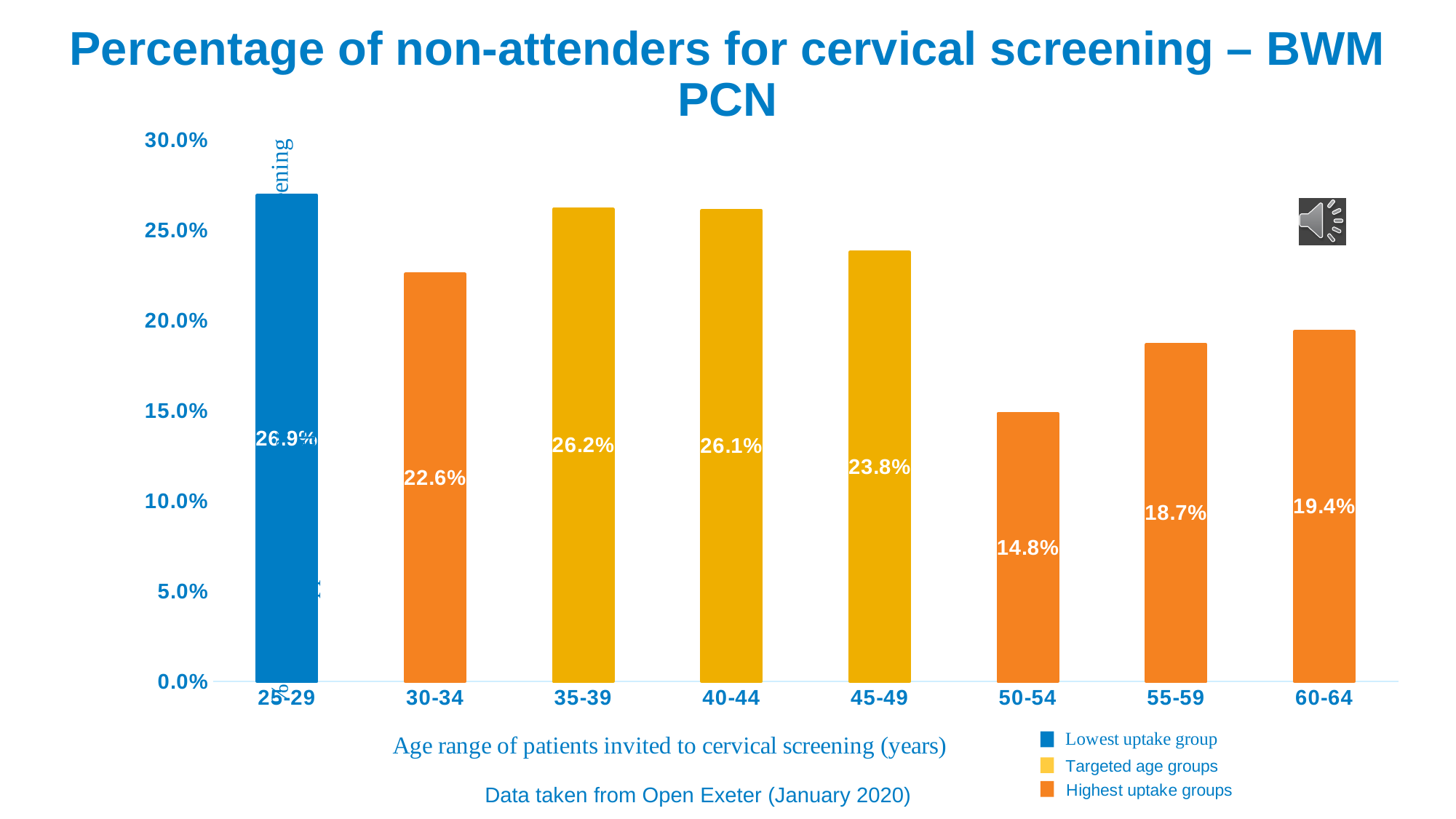
What is the percentage of non-attenders for the 50-54 age group? 14.8% How many entries does the legend list? 3 Which age group has a higher percentage of non-attenders, 45-49 or 55-59? 45-49 What is the difference in percentage points between the 35-39 and 50-54 age groups? 11.4 What is the percentage of non-attenders for the 30-34 age group? 22.6% What kind of chart is shown on the slide? Bar chart Which age group has the lowest percentage of non-attenders? 50-54 How many age groups are shown on the x axis? 8 What is the percentage of non-attenders for the 60-64 age group? 19.4% Which age group has the highest percentage of non-attenders? 25-29 Is the value for the 40-44 age group greater or less than 25.0%? greater Which legend entry is shown in blue? Lowest uptake group